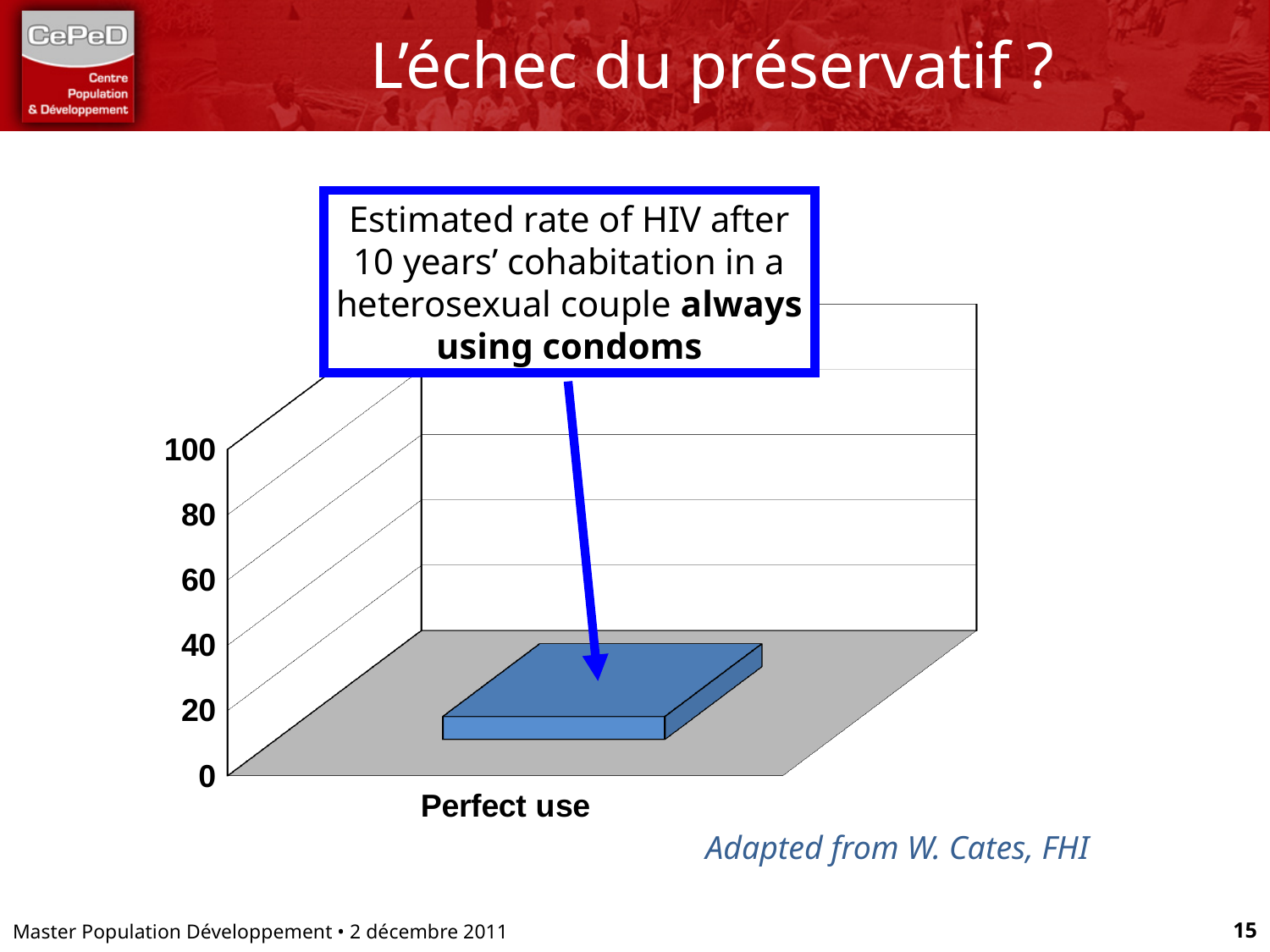
What kind of chart is shown on the slide? bar chart What is the lowest tick value shown on the vertical axis of the chart? 0 What is the highest value shown on the vertical axis of the chart? 100 What is the interval between consecutive tick marks on the vertical axis? 20 Is the value for Perfect use greater or less than 40? less How many categories are plotted on the x axis of the chart? 1 Is the value for Perfect use greater or less than 60? less What is the label of the single category on the x axis? Perfect use